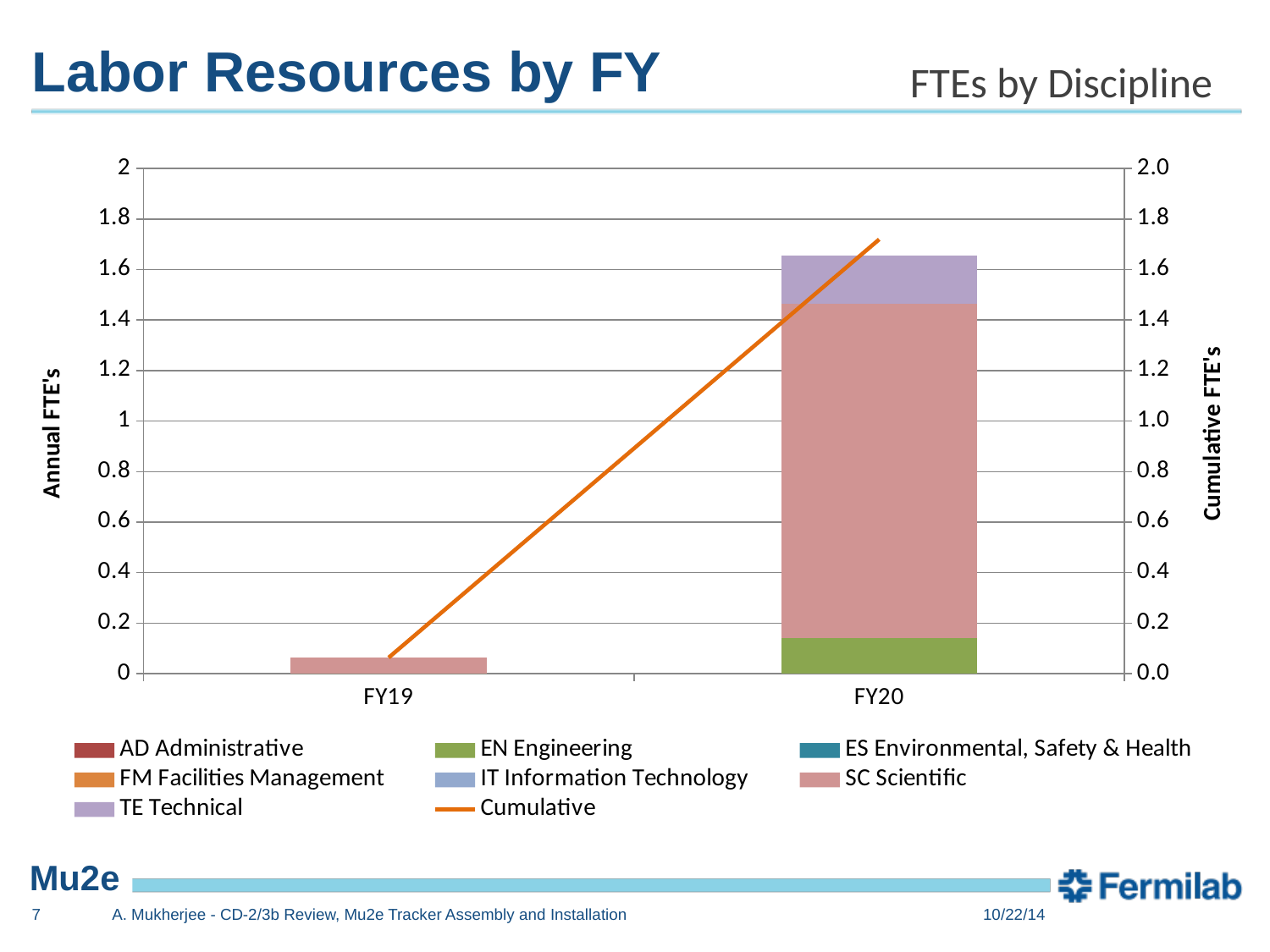
Is the SC Scientific segment in FY20 greater or less than 1.0 annual FTEs? greater Which fiscal year has the shorter stacked bar? FY19 Is the total annual FTE bar for FY20 greater or less than 1.4? greater Does the Cumulative line rise or fall from FY19 to FY20? rises What kind of chart is shown on the slide? Stacked bar chart with a line Is the EN Engineering segment in FY20 greater or less than 0.4 annual FTEs? less How many entries does the legend list? 8 Which fiscal year has the taller stacked bar? FY20 What is the title of the left vertical axis? Annual FTE's What is the title of the right vertical axis? Cumulative FTE's How many fiscal year categories are shown on the x axis? 2